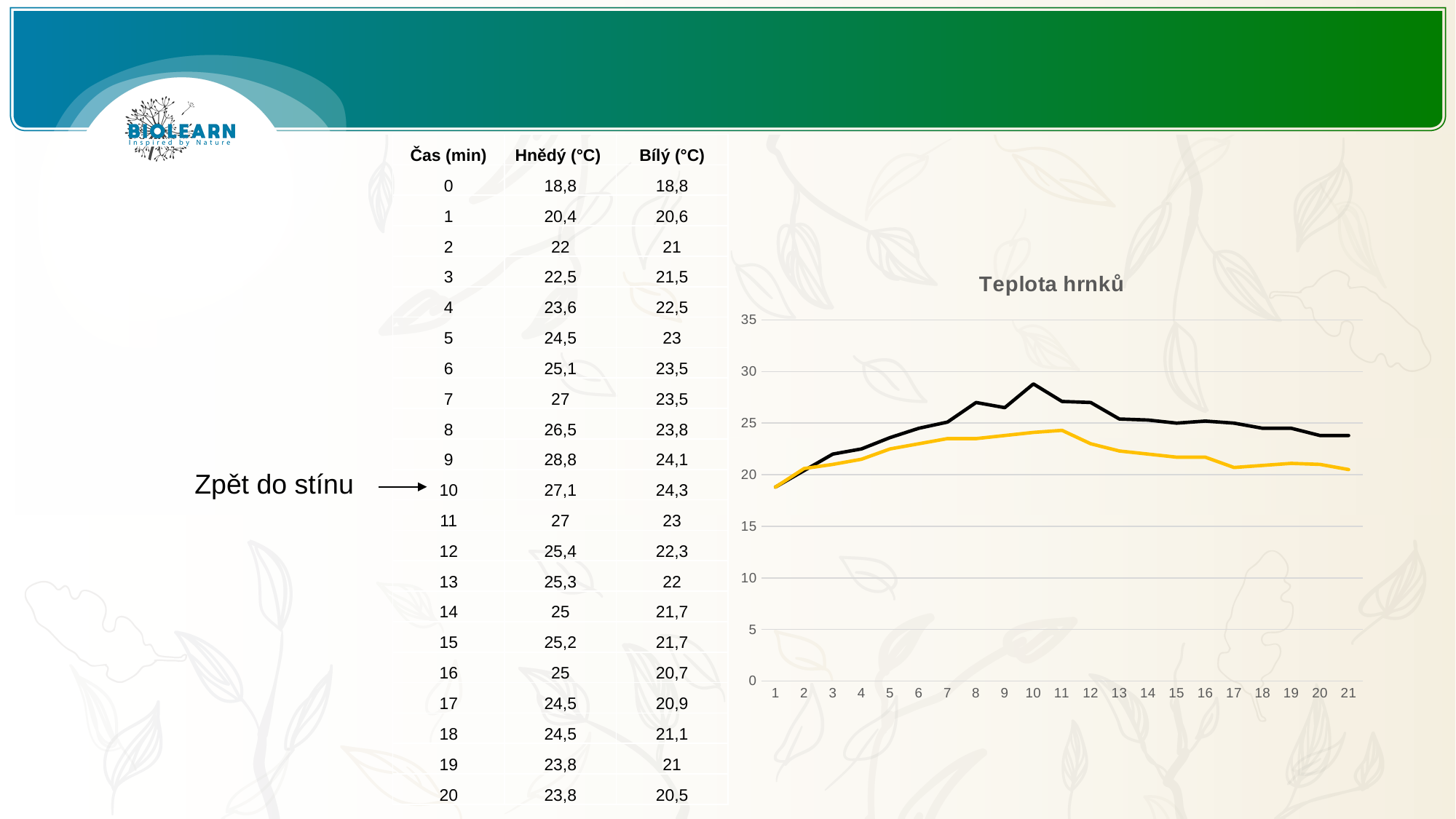
In the "Teplota hrnků" chart, does the yellow line rise or fall from x = 11 to x = 21? fall In the "Teplota hrnků" chart, is the value of the yellow line at x = 21 greater or less than 25? less What is the highest tick value shown on the y axis of the "Teplota hrnků" chart? 35 In the "Teplota hrnků" chart, at which x-axis position does the black line reach its highest value? 10 How many lines are plotted in the "Teplota hrnků" chart? 2 What kind of chart is "Teplota hrnků"? line chart In the "Teplota hrnků" chart, is the value of the black line at x = 21 greater or less than 25? less In the "Teplota hrnků" chart, is the value of the black line at x = 10 greater or less than 25? greater In the "Teplota hrnků" chart, which line is higher at x = 10, the black line or the yellow line? black line What is the title of the chart on the right of the slide? Teplota hrnků How many points are labelled along the x axis of the "Teplota hrnků" chart? 21 In the "Teplota hrnků" chart, at which x-axis position does the yellow line reach its highest value? 11